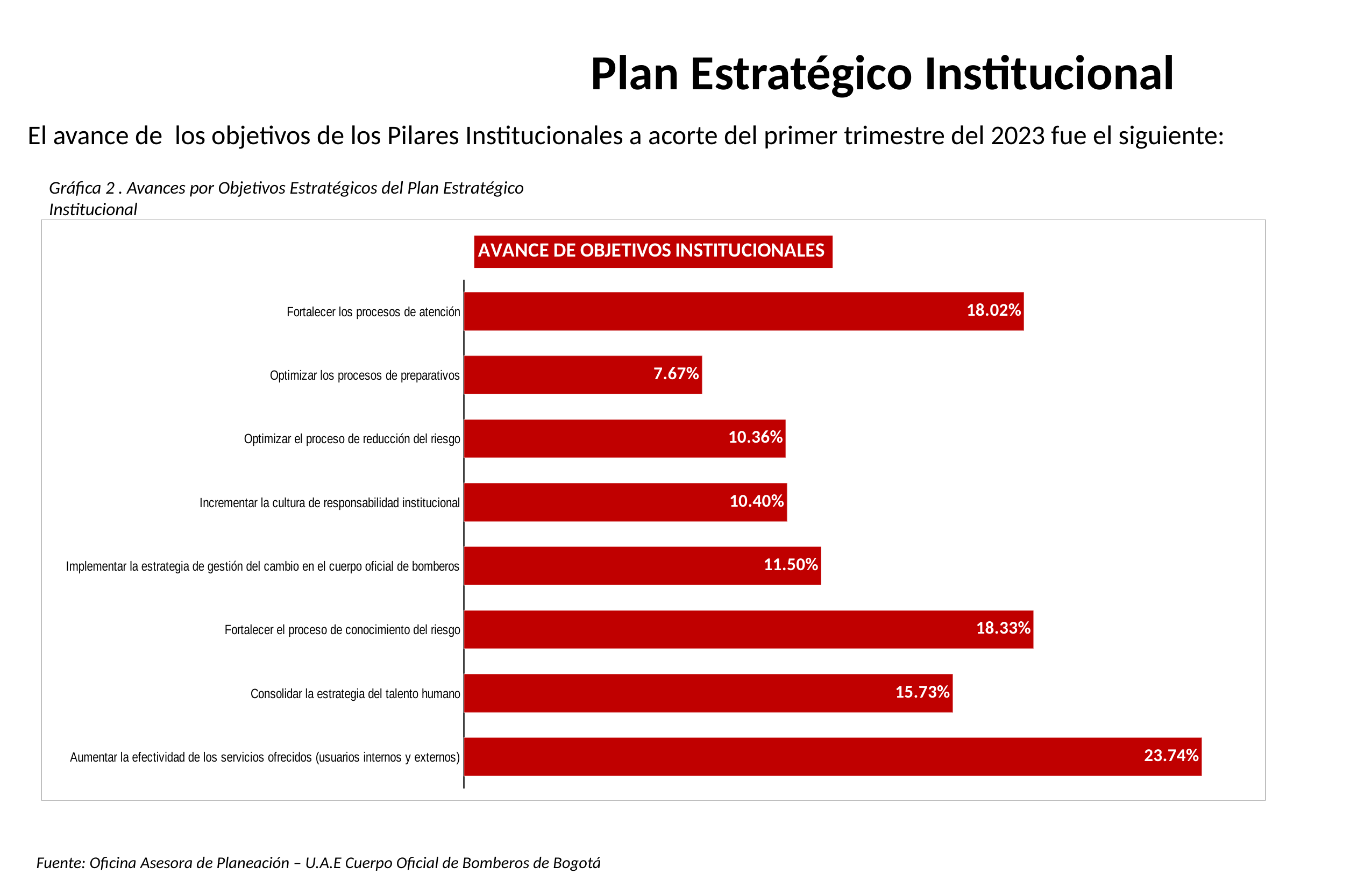
What is the value for 'Implementar la estrategia de gestión del cambio en el cuerpo oficial de bomberos'? 11.50% Which objective has the lowest value? Optimizar los procesos de preparativos What is the title of the chart? AVANCE DE OBJETIVOS INSTITUCIONALES Which objective has the highest value? Aumentar la efectividad de los servicios ofrecidos (usuarios internos y externos) What type of chart is shown on the slide? Bar chart What is the difference between 'Fortalecer el proceso de conocimiento del riesgo' and 'Fortalecer los procesos de atención'? 0.31% Which is larger: the value for 'Consolidar la estrategia del talento humano' or for 'Implementar la estrategia de gestión del cambio en el cuerpo oficial de bomberos'? Consolidar la estrategia del talento humano What is the value for 'Consolidar la estrategia del talento humano'? 15.73% What is the value for 'Fortalecer los procesos de atención'? 18.02% What is the value for 'Optimizar los procesos de preparativos'? 7.67% How many objectives (categories) are plotted in the chart? 8 What is the difference between the highest value (23.74%) and the lowest value (7.67%)? 16.07%